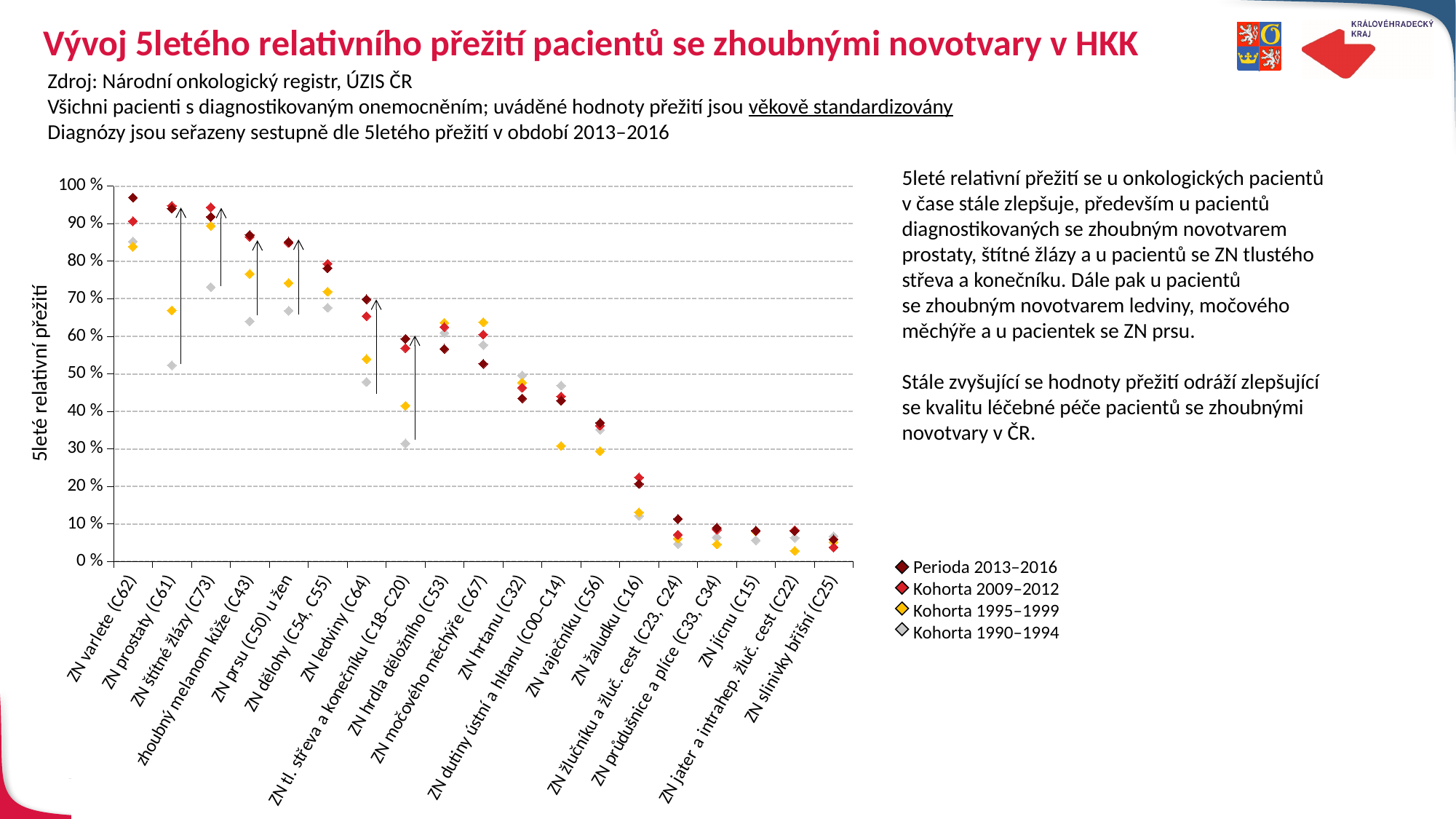
Is the Kohorta 1990–1994 value for ZN tl. střeva a konečníku (C18–C20) greater or less than 40 %? less What kind of chart is shown on the slide? scatter chart Is the Perioda 2013–2016 value for ZN varlete (C62) greater or less than 90 %? greater How many diagnosis categories are plotted along the x axis? 19 Is the Kohorta 1990–1994 value for ZN prostaty (C61) greater or less than 60 %? less For ZN prostaty (C61), which is larger: the Perioda 2013–2016 value or the Kohorta 1990–1994 value? Perioda 2013–2016 Which category has the highest value for the series Perioda 2013–2016? ZN varlete (C62) How many series does the legend list? 4 Do the Perioda 2013–2016 values generally rise or fall from left to right along the x axis? fall What is the label of the vertical axis? 5leté relativní přežití